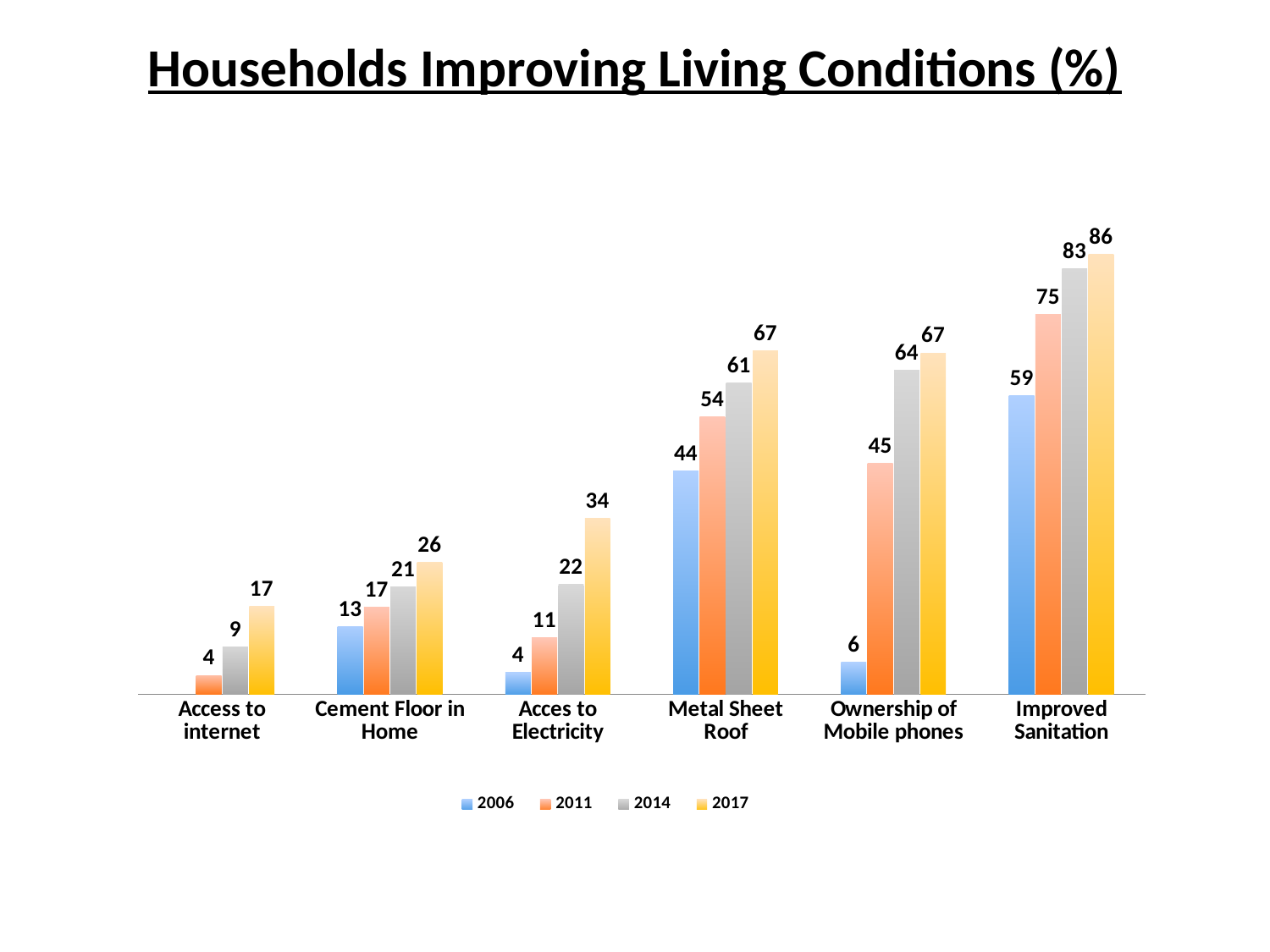
For Cement Floor in Home, do the values rise or fall from 2006 to 2017? rise What type of chart is shown on the slide? bar chart What is the title of the chart? Households Improving Living Conditions (%) Which category has the highest value in 2017? Improved Sanitation Which is larger, the 2014 value for Metal Sheet Roof or the 2014 value for Ownership of Mobile phones? Ownership of Mobile phones What is the value for Ownership of Mobile phones in 2006? 6 How many series does the legend list? 4 What is the value for Improved Sanitation in 2017? 86 Which category has the lowest value in 2011? Access to internet What is the difference between the 2017 and 2006 values for Ownership of Mobile phones? 61 What is the value for Acces to Electricity in 2014? 22 How many categories are shown on the x axis? 6